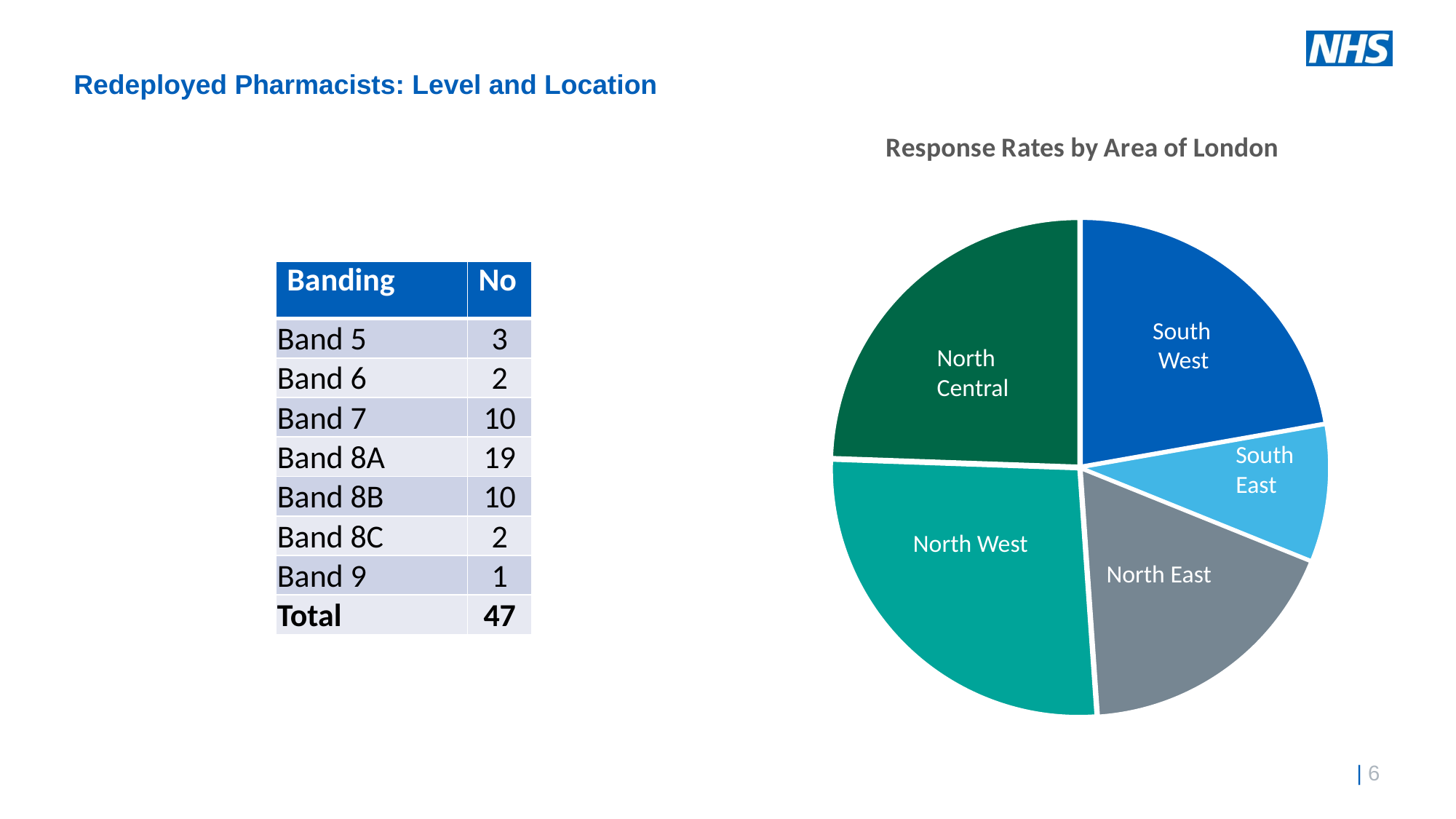
In the pie chart, which slice is larger: North West or South East? North West Which area has the smallest slice in the pie chart? South East What colour is the North East slice in the pie chart? grey In the pie chart, which slice is larger: North East or South East? North East What is the title of the pie chart? Response Rates by Area of London In the pie chart, which slice is larger: South West or South East? South West What kind of chart is shown on the slide? pie chart Which area's slice is shown in light blue in the pie chart? South East How many areas of London are shown as slices in the pie chart? 5